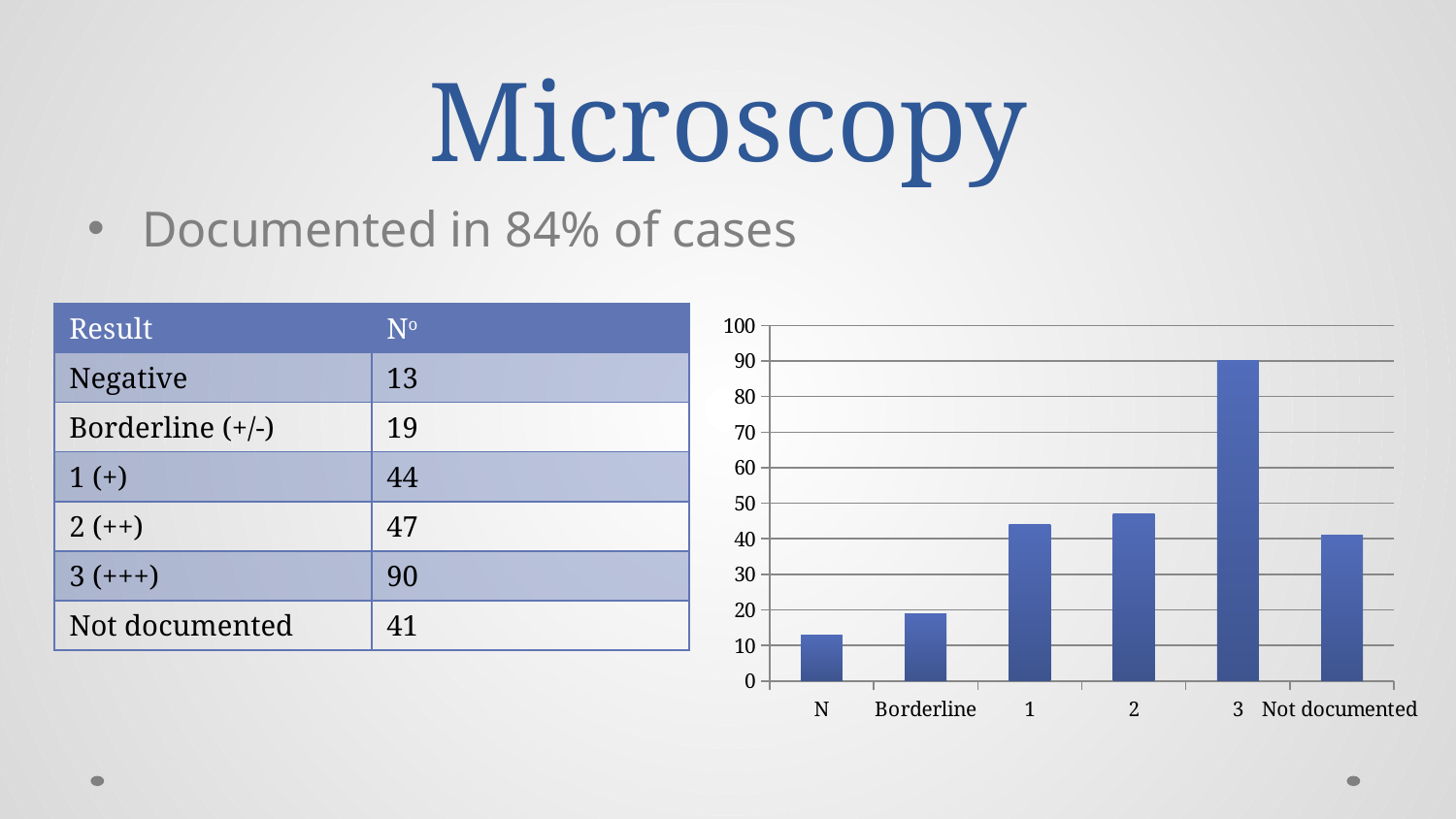
What is the difference between the value for 3 and the value for Not documented? 49 Which is larger, the bar for 3 or the bar for Not documented? 3 How many categories are shown on the x axis of the chart? 6 What is the value of the bar for Not documented? 41 Which category has the lowest bar in the chart? N Do the bar values rise or fall from N through to 3 along the x axis? rise What kind of chart is shown on the slide? bar chart Is the value for Borderline greater or less than 20? less Is the value for Not documented greater or less than 40? greater What is the value of the bar for category 3? 90 Which category has the highest bar in the chart? 3 What is the value of the bar for category N? 13